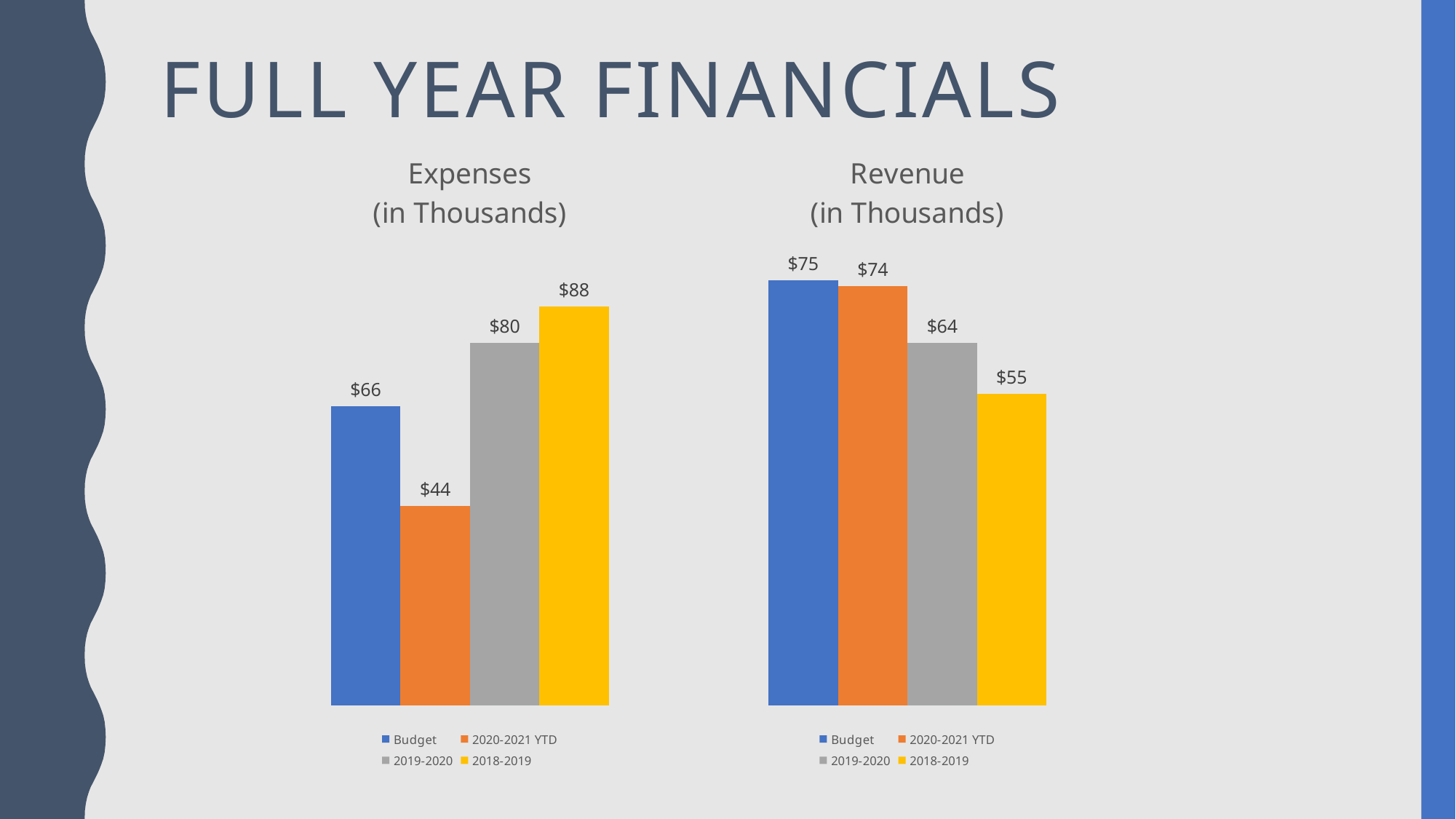
In the Revenue (in Thousands) chart, which series has the lowest value? 2018-2019 In the Revenue (in Thousands) chart, what is the difference between the Budget value and the 2018-2019 value? $20 What kind of chart is the Expenses (in Thousands) chart? Bar chart In the Expenses (in Thousands) chart, which is larger, the Budget value or the 2019-2020 value? 2019-2020 In the Expenses (in Thousands) chart, which series has the lowest value? 2020-2021 YTD In the Expenses (in Thousands) chart, what is the value for 2020-2021 YTD? $44 How many series does the legend of the Revenue (in Thousands) chart list? 4 In the Expenses (in Thousands) chart, what is the difference between the 2018-2019 value and the 2020-2021 YTD value? $44 In the Expenses (in Thousands) chart, what is the value for Budget? $66 In the Revenue (in Thousands) chart, what is the value for 2019-2020? $64 In the Expenses (in Thousands) chart, which series has the highest value? 2018-2019 In the Revenue (in Thousands) chart, what is the value for 2018-2019? $55